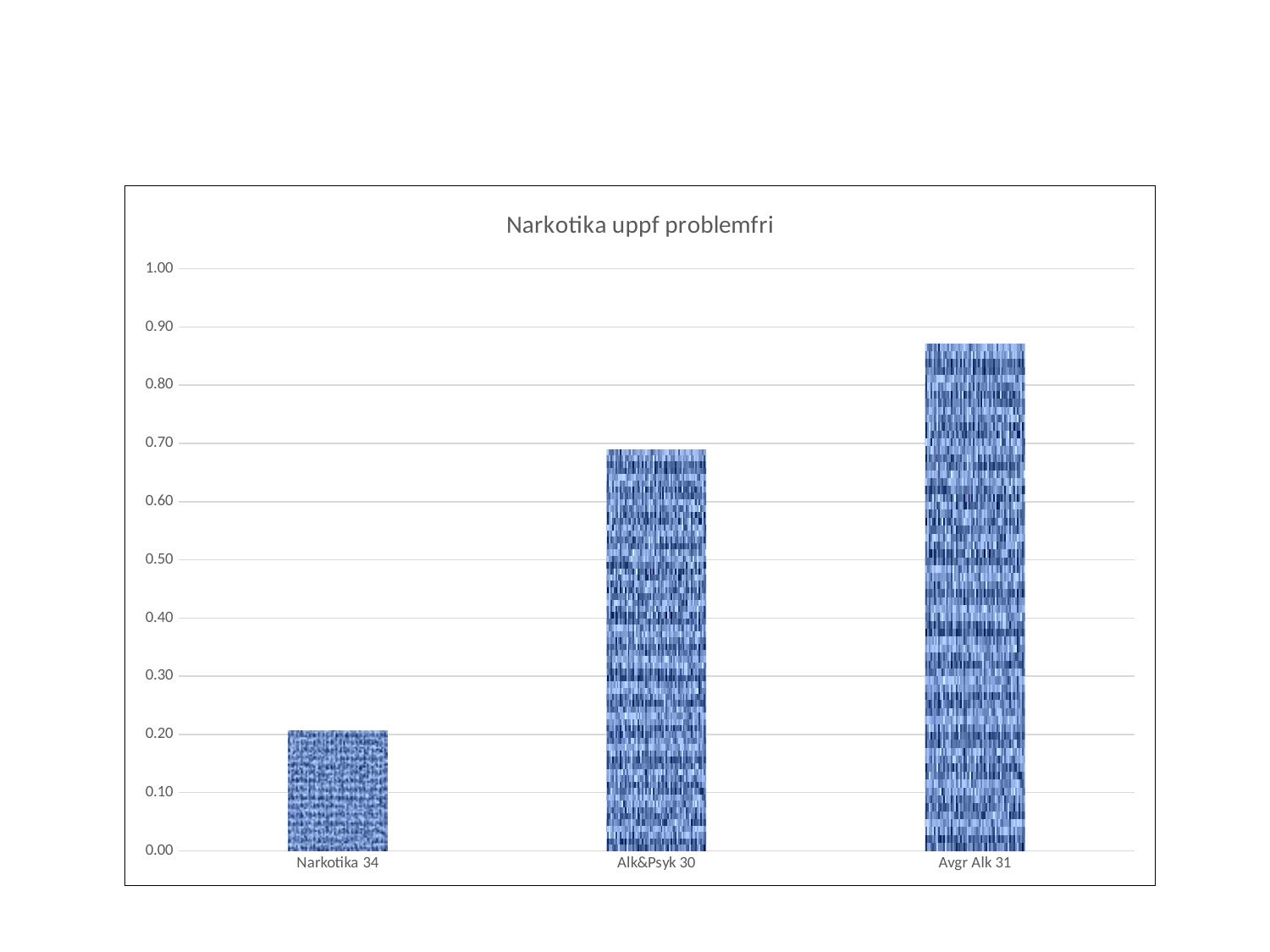
Which category has the lowest value? Narkotika 34 Is the value for Avgr Alk 31 greater or less than 0.90? less What is the title of the chart? Narkotika uppf problemfri Which is larger, the value for Alk&Psyk 30 or the value for Avgr Alk 31? Avgr Alk 31 What kind of chart is shown on the slide? bar chart Do the bar values rise or fall from left to right across the categories? rise Which category has the highest value? Avgr Alk 31 Is the value for Alk&Psyk 30 greater or less than 0.60? greater Is the value for Avgr Alk 31 greater or less than 0.80? greater How many categories are plotted in the chart? 3 Which is larger, the value for Narkotika 34 or the value for Alk&Psyk 30? Alk&Psyk 30